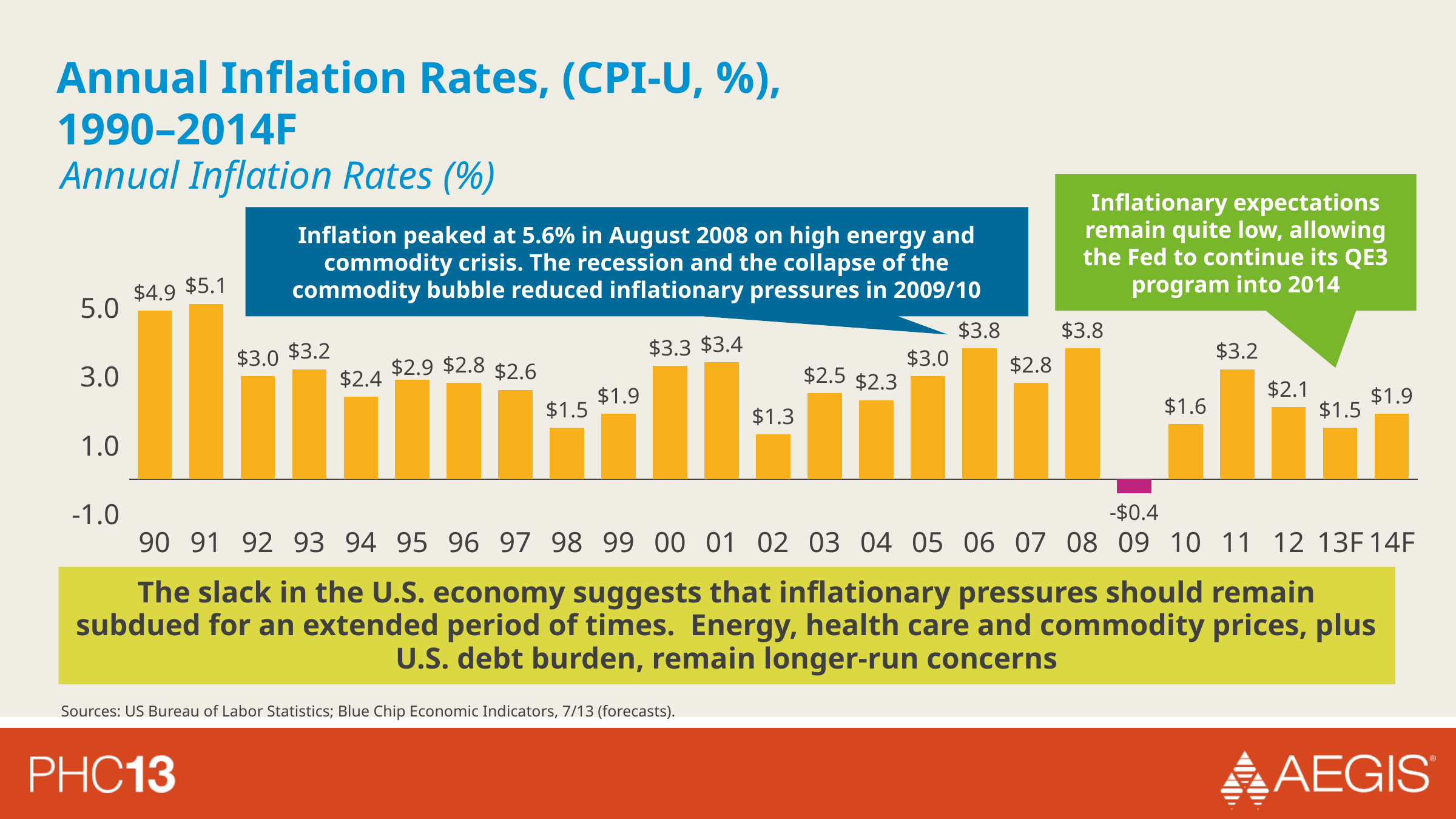
What is the value shown for 91? $5.1 Which year has the lowest value in the chart? 09 What is the value shown for 01? $3.4 Do the values rise or fall from 11 to 13F? Fall Which year has the highest value in the chart? 91 How many years (bars) are shown in the chart? 25 What is the difference between the values for 91 and 92? $2.1 What is the value shown for 14F? $1.9 Is the value for 06 greater or less than 3.0? greater Which is larger, the value for 00 or the value for 02? 00 What is the value shown for 09? -$0.4 What kind of chart is shown on the slide? Bar chart